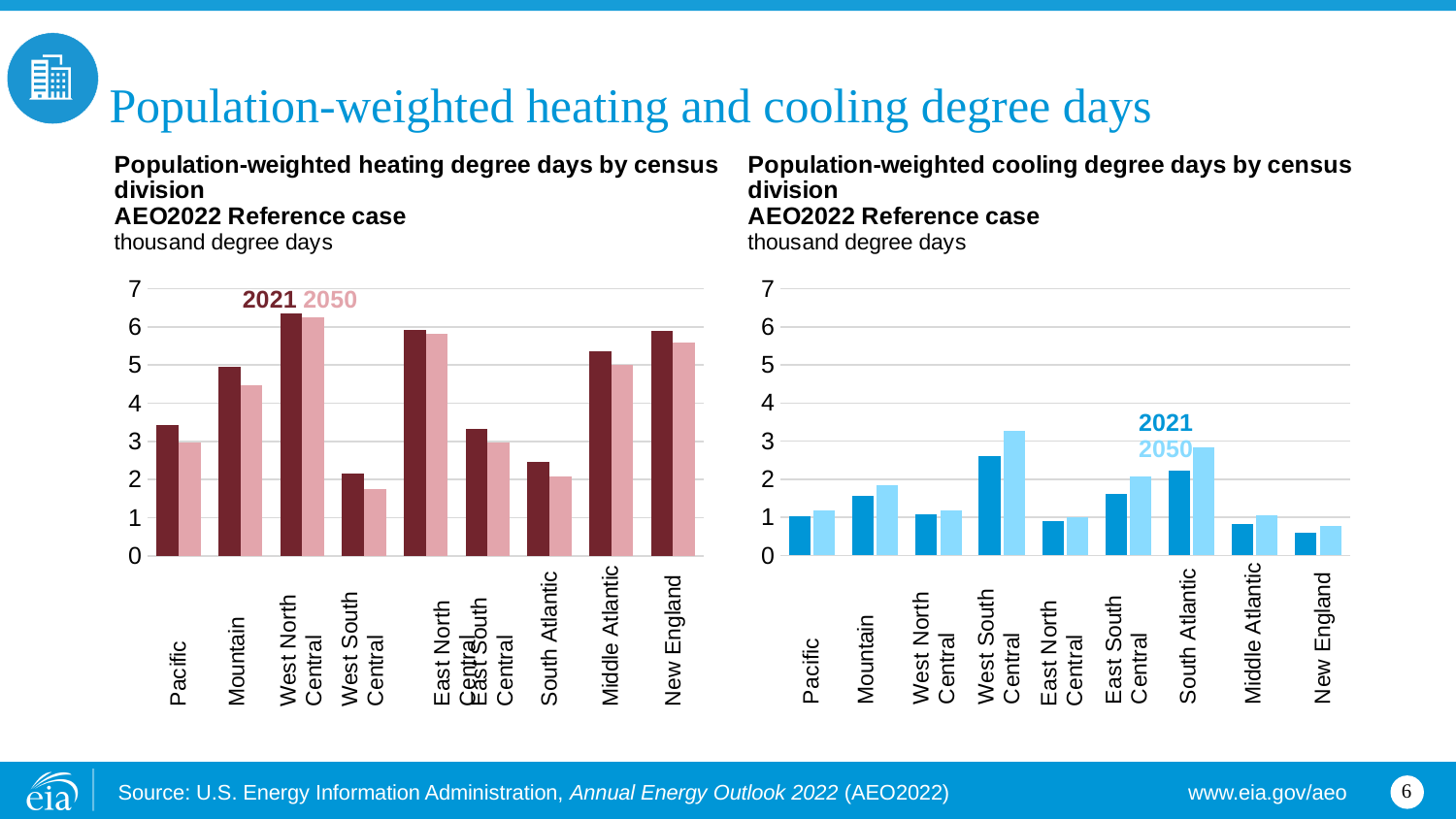
How many census divisions are shown on the x axis of the heating degree days chart? 9 In the heating degree days chart, which census division has the lowest 2021 value? West South Central In the heating degree days chart, is the 2021 value for West North Central greater or less than 6? greater In the cooling degree days chart, which census division has the lowest 2021 value? New England In the cooling degree days chart, which is larger: the 2050 value for South Atlantic or the 2050 value for East South Central? South Atlantic In the heating degree days chart, which is larger: the 2021 value for Mountain or the 2021 value for Middle Atlantic? Middle Atlantic What unit is used on the y axis of both charts? thousand degree days In the cooling degree days chart, is the 2050 value for West South Central greater or less than 3? greater How many series does the cooling degree days chart show? 2 What kind of chart is the population-weighted heating degree days chart on the left? bar chart In the cooling degree days chart, which census division has the highest 2050 value? West South Central In the heating degree days chart, which census division has the highest 2021 value? West North Central